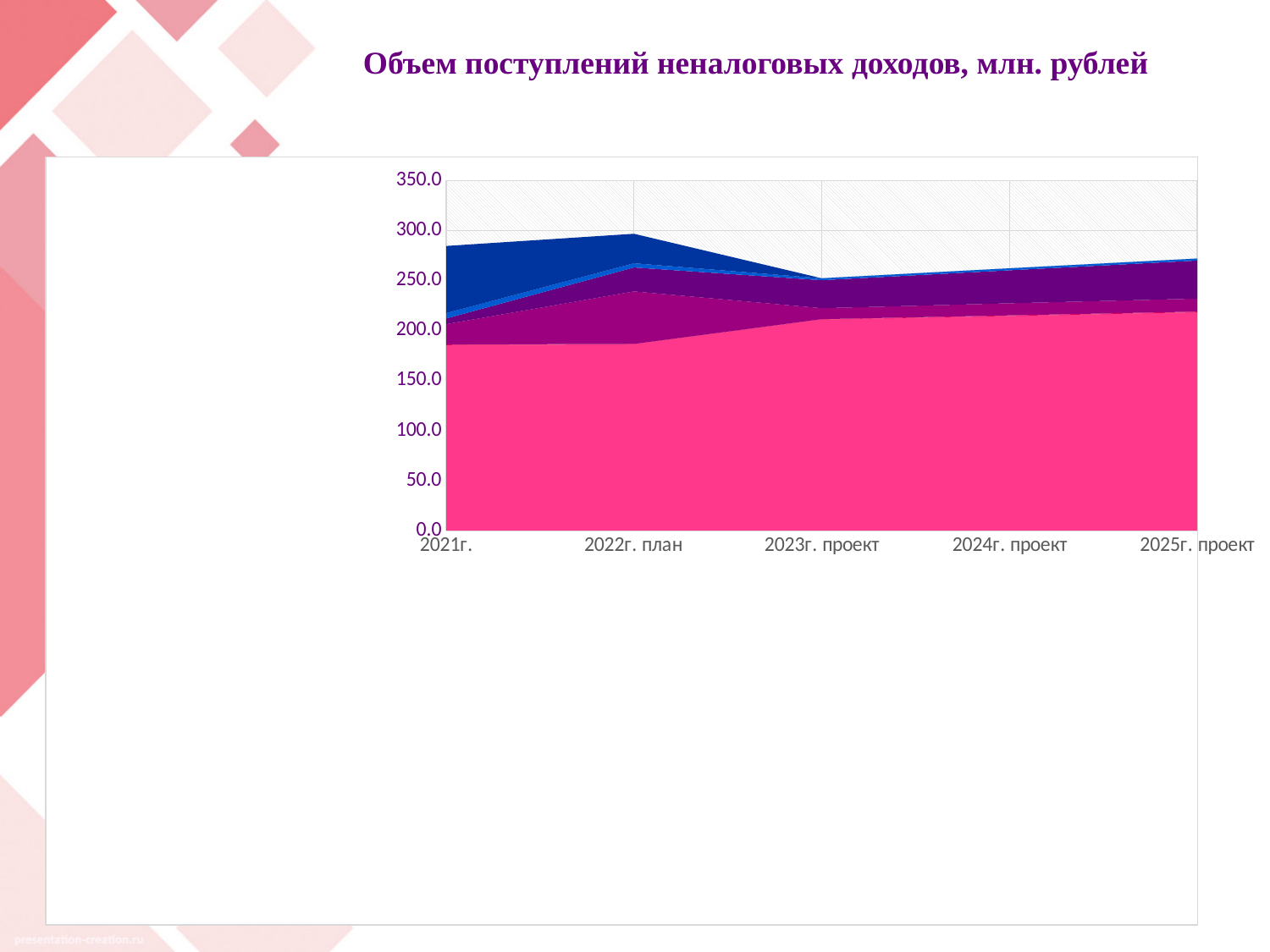
Is the value of the bottom (pink) series for 2025г. проект greater or less than 200.0? greater Is the total stacked value for 2021г. greater or less than 250.0? greater In which category does the total stacked value reach its highest point? 2022г. план Is the value of the bottom (pink) series for 2021г. greater or less than 200.0? less What is the title of the chart on the slide? Объем поступлений неналоговых доходов, млн. рублей How many categories are shown along the x axis of the chart? 5 What is the highest value shown on the y axis of the chart? 350.0 Does the bottom (pink) series rise or fall from 2021г. to 2025г. проект? rise What kind of chart is shown on the slide? area chart Which has a larger total stacked value: 2022г. план or 2023г. проект? 2022г. план